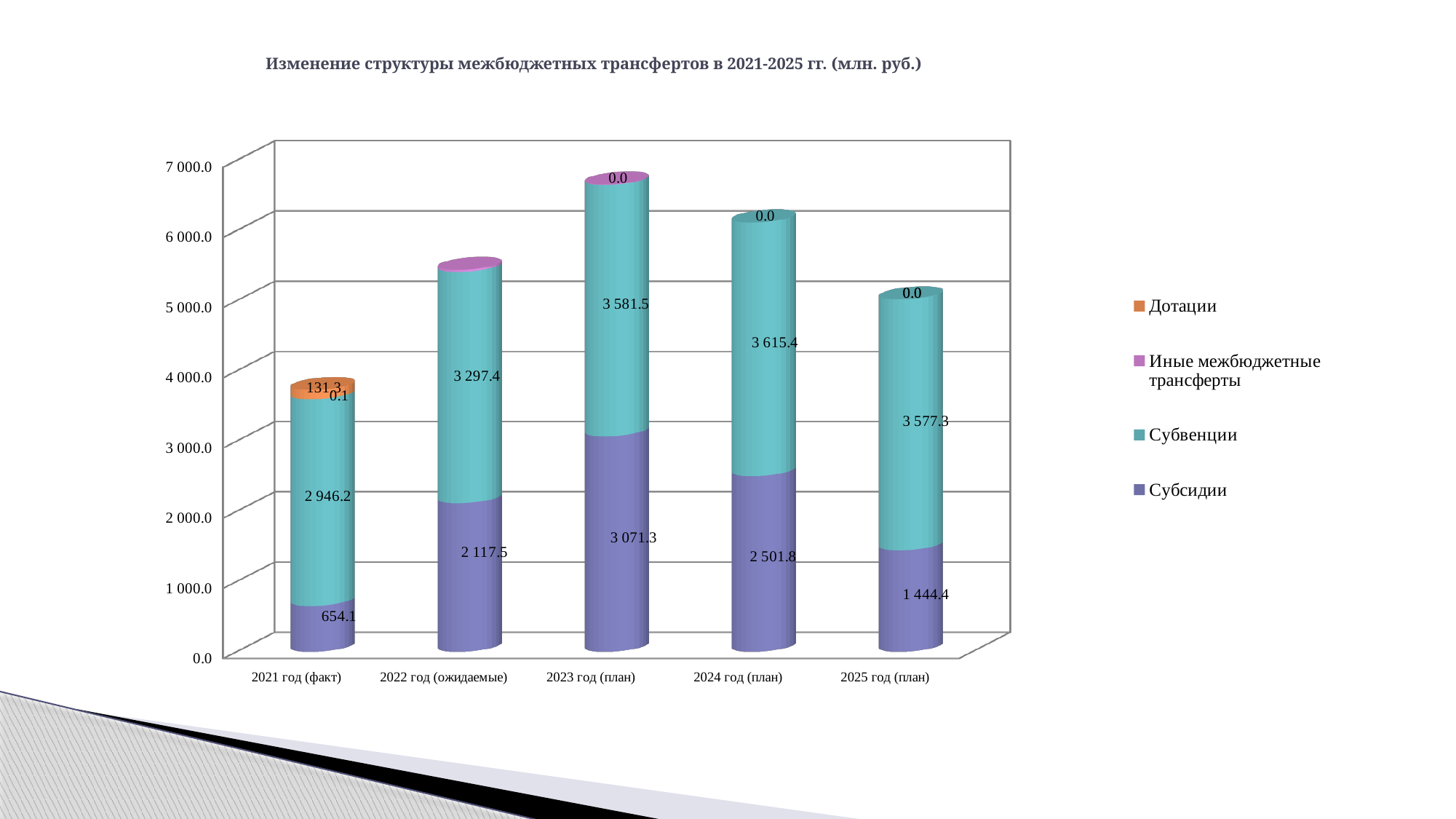
What is the value of Дотации for 2021 год (факт)? 131.3 What is the value of Субсидии for 2023 год (план)? 3 071.3 What is the difference between the Субсидии values for 2023 год (план) and 2022 год (ожидаемые)? 953.8 In which year is the Субвенции value the highest? 2024 год (план) In which year is the Субсидии value the lowest? 2021 год (факт) How many series does the legend list? 4 Which year has the larger Субсидии value, 2024 год (план) or 2025 год (план)? 2024 год (план) How many years (categories) are shown on the x axis? 5 Do the Субсидии values rise or fall from 2023 год (план) to 2025 год (план)? Fall What is the value of Субвенции for 2024 год (план)? 3 615.4 What kind of chart is shown on the slide? Stacked bar chart